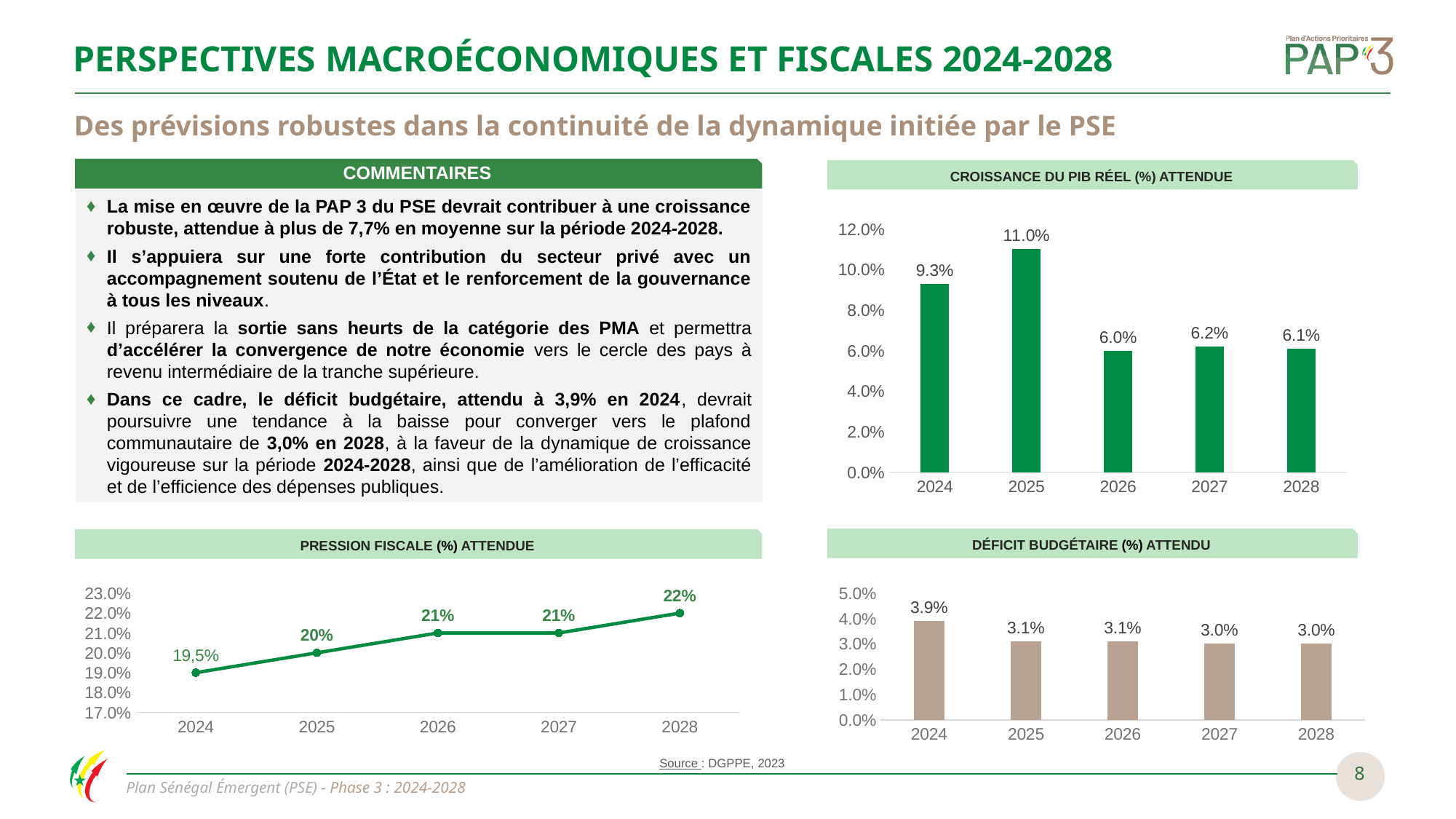
In the chart titled 'DÉFICIT BUDGÉTAIRE (%) ATTENDU', what is the difference between the values for 2024 and 2025? 0.8% In the chart titled 'PRESSION FISCALE (%) ATTENDUE', do the values generally rise or fall from 2024 to 2028? Rise In the chart titled 'DÉFICIT BUDGÉTAIRE (%) ATTENDU', what is the value for 2024? 3.9% In the chart titled 'PRESSION FISCALE (%) ATTENDUE', which year has the highest value? 2028 In the chart titled 'CROISSANCE DU PIB RÉEL (%) ATTENDUE', which year has the lowest value? 2026 In the chart titled 'CROISSANCE DU PIB RÉEL (%) ATTENDUE', what is the value for 2025? 11.0% In the chart titled 'CROISSANCE DU PIB RÉEL (%) ATTENDUE', how many years are shown on the x axis? 5 In the chart titled 'DÉFICIT BUDGÉTAIRE (%) ATTENDU', which is larger, the value for 2024 or the value for 2028? 2024 In the chart titled 'PRESSION FISCALE (%) ATTENDUE', what is the value for 2024? 19,5% What kind of chart is the one titled 'PRESSION FISCALE (%) ATTENDUE'? Line chart What kind of chart is the one titled 'CROISSANCE DU PIB RÉEL (%) ATTENDUE'? Bar chart In the chart titled 'CROISSANCE DU PIB RÉEL (%) ATTENDUE', what is the difference between the values for 2025 and 2024? 1.7%